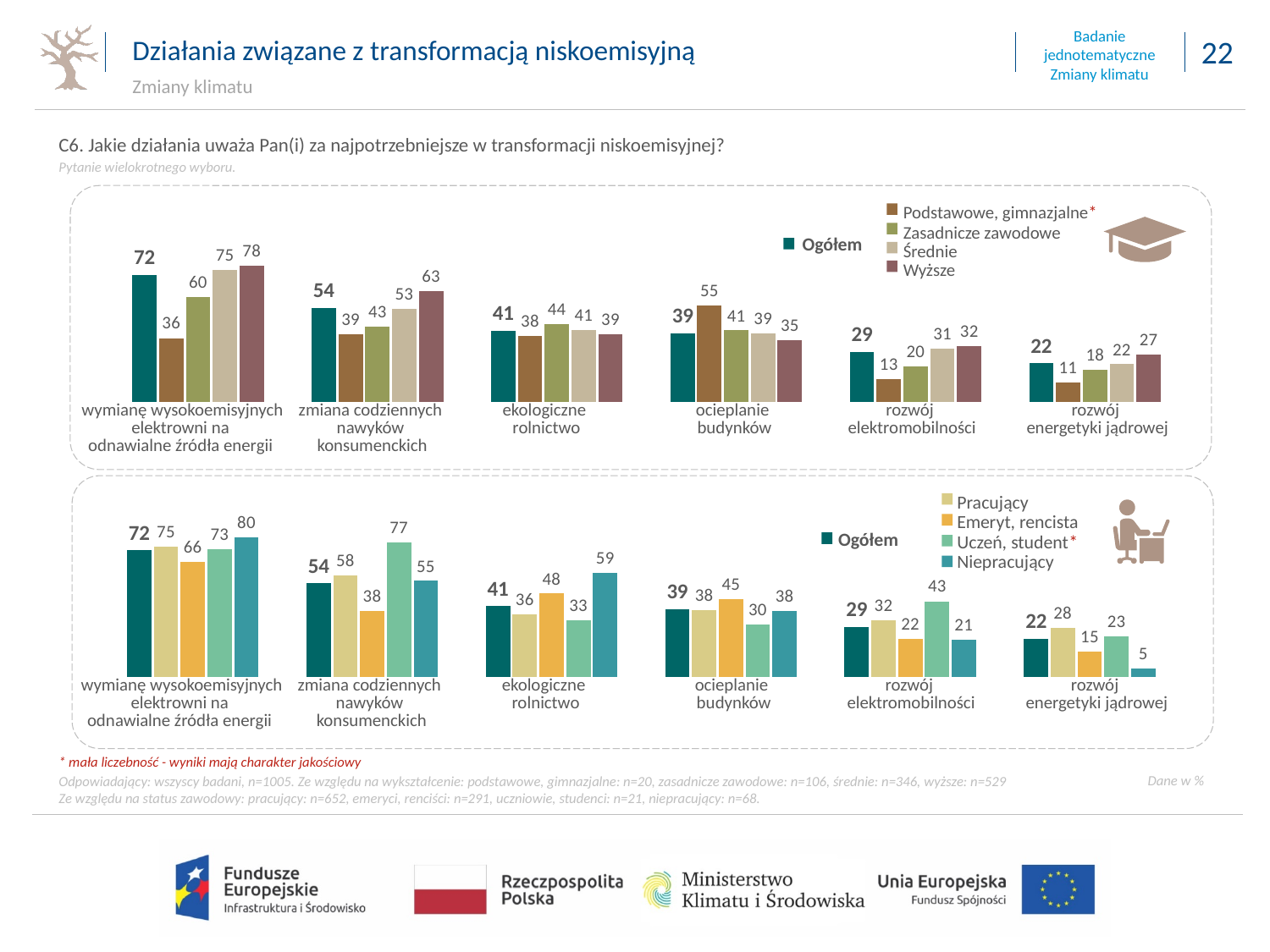
In the bottom chart (by occupational status), is the 'Emeryt, rencista' value for 'ocieplanie budynków' larger or smaller than the 'Uczeń, student' value? larger In the top chart (by education), which category has the lowest Ogółem value? rozwój energetyki jądrowej In the top chart (by education), how many series does the legend list? 5 In the bottom chart (by occupational status), what is the value for 'Niepracujący' in the 'ekologiczne rolnictwo' category? 59 What type of chart is the top chart (by education)? bar chart In the top chart (by education), what is the difference between the 'Wyższe' and 'Podstawowe, gimnazjalne' values for 'zmiana codziennych nawyków konsumenckich'? 24 In the top chart (by education), what is the value for 'Podstawowe, gimnazjalne' in the 'ocieplanie budynków' category? 55 How many categories are shown on the x axis of the bottom chart (by occupational status)? 6 In the bottom chart (by occupational status), what is the lowest value shown for 'rozwój energetyki jądrowej'? 5 In the top chart (by education), what is the Ogółem value for 'wymianę wysokoemisyjnych elektrowni na odnawialne źródła energii'? 72 In the bottom chart (by occupational status), what is the difference between the 'Uczeń, student' and 'Niepracujący' values for 'rozwój elektromobilności'? 22 In the bottom chart (by occupational status), which series has the highest value for 'zmiana codziennych nawyków konsumenckich'? Uczeń, student